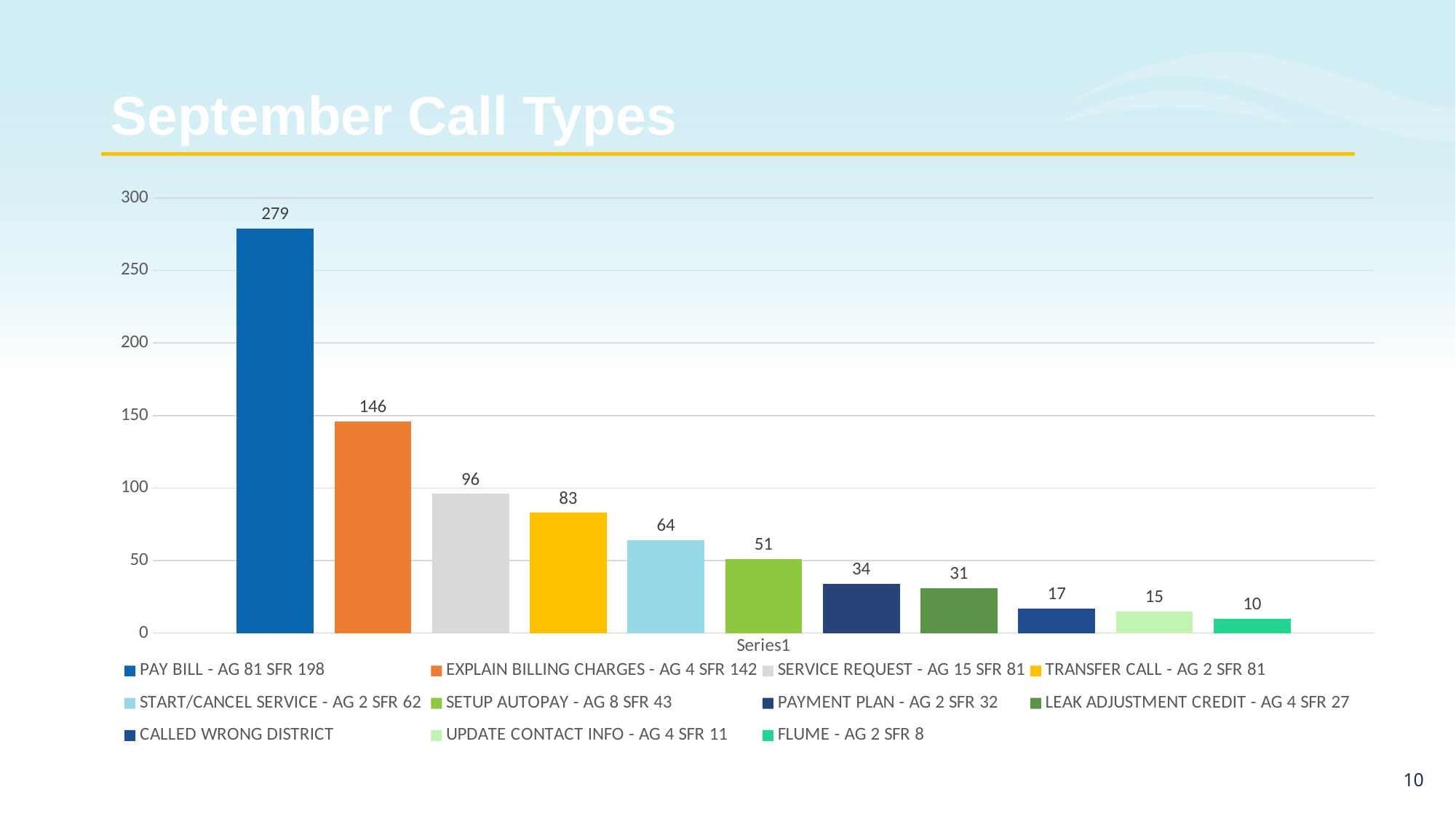
What is the value of the EXPLAIN BILLING CHARGES bar? 146 What is the title of the slide? September Call Types Which is larger, the SERVICE REQUEST value or the START/CANCEL SERVICE value? SERVICE REQUEST What is the difference between the PAY BILL value and the EXPLAIN BILLING CHARGES value? 133 Is the value for SETUP AUTOPAY greater or less than 100? less What is the value of the TRANSFER CALL bar? 83 Which call type has the lowest value? FLUME How many bars are shown in the chart? 11 What is the value of the PAY BILL bar? 279 Which call type has the highest value? PAY BILL What kind of chart is shown on the slide? bar chart What is the value of the FLUME bar? 10